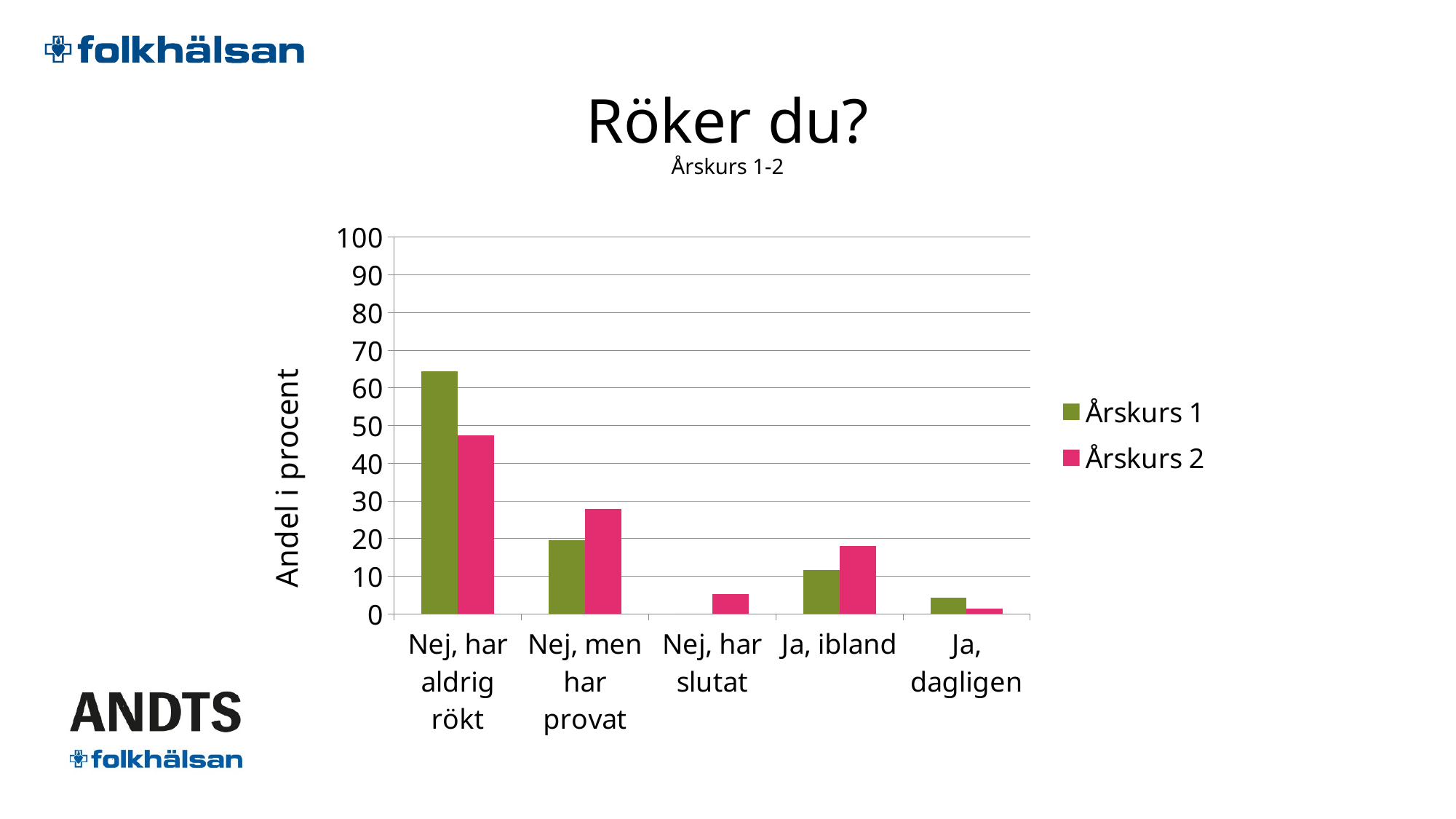
For 'Nej, har aldrig rökt', which series has the larger value, Årskurs 1 or Årskurs 2? Årskurs 1 Is the value for Årskurs 1 in 'Ja, dagligen' greater or less than 10? less What kind of chart is shown on the slide? bar chart Is the value for Årskurs 2 in 'Nej, men har provat' greater or less than 20? greater How many answer categories are shown on the x axis? 5 How many series does the legend list? 2 What is the title of the y axis? Andel i procent Which category has the highest value for Årskurs 2? Nej, har aldrig rökt Is the value for Årskurs 1 in 'Nej, har aldrig rökt' greater or less than 60? greater Which category has the highest value for Årskurs 1? Nej, har aldrig rökt For 'Nej, men har provat', which series has the larger value, Årskurs 1 or Årskurs 2? Årskurs 2 Which category has the lowest value for Årskurs 2? Ja, dagligen